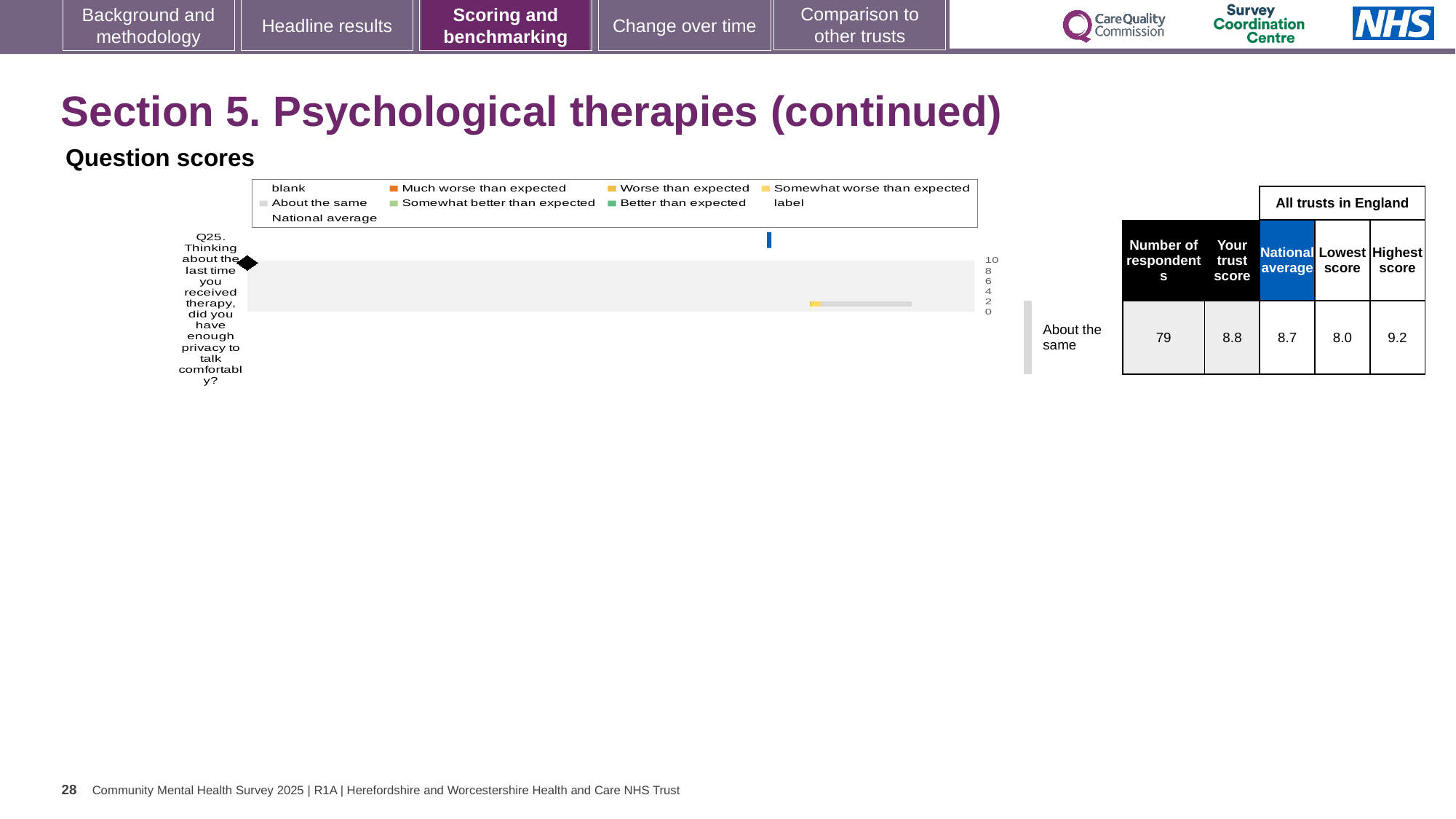
In the table beside the chart, what is the national average for Q25? 8.7 Which question is plotted in the Question scores chart? Q25. Thinking about the last time you received therapy, did you have enough privacy to talk comfortably? In the table beside the chart, what is the lowest score among all trusts in England for Q25? 8.0 For Q25, what is the difference between the highest score and the lowest score among all trusts in England? 1.2 What kind of chart is shown under 'Question scores'? bar chart In the table beside the chart, what is the highest score among all trusts in England for Q25? 9.2 How many survey questions are plotted in the Question scores chart? 1 In the table beside the chart, what is the number of respondents for Q25? 79 In the table beside the chart, what is the trust's score for Q25? 8.8 For Q25, which is larger: the trust's score or the national average? the trust's score Which benchmarking category is the trust's Q25 score placed in? About the same What is the highest value shown on the axis of the Question scores chart? 10